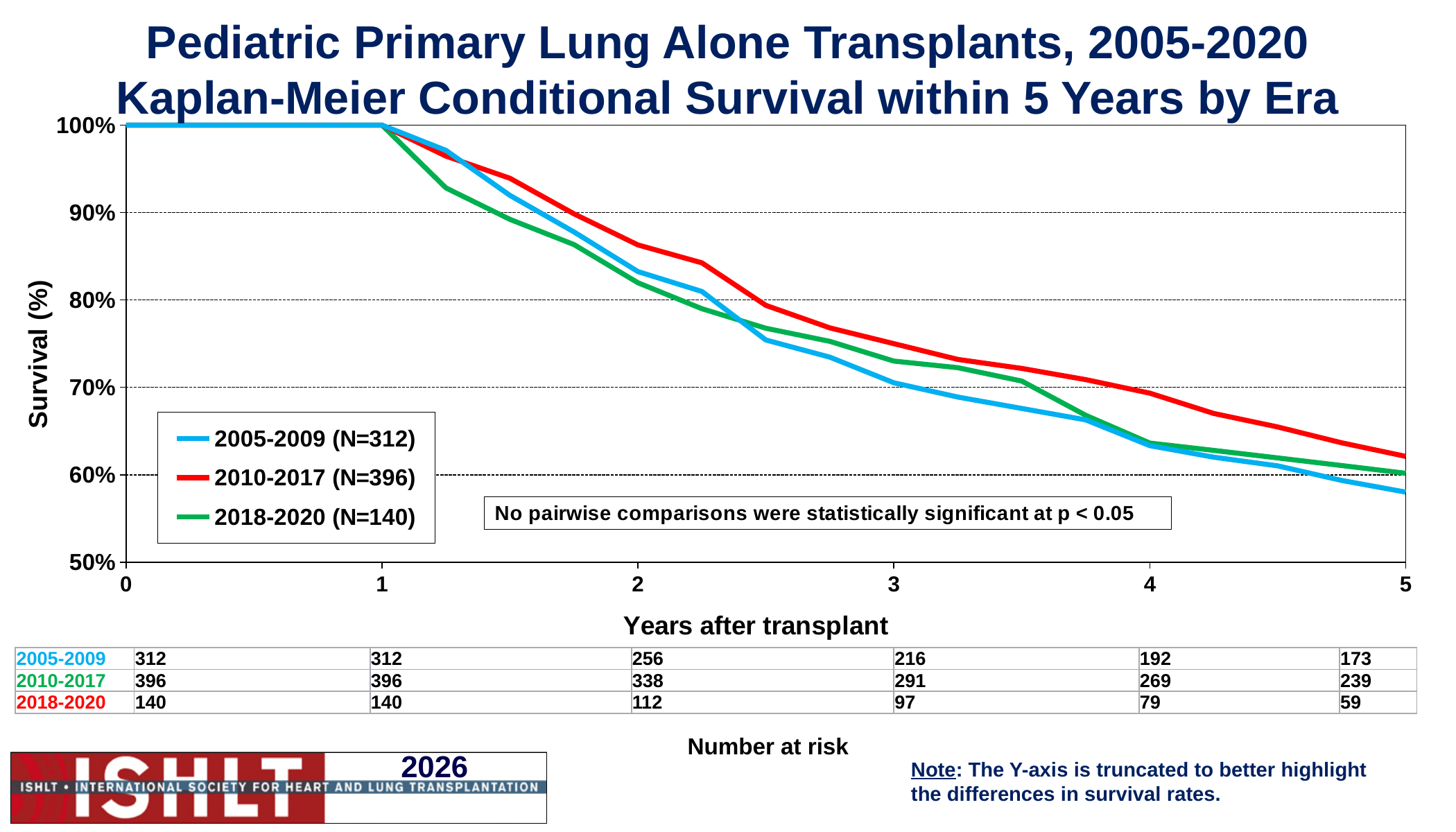
How many series does the legend list? 3 Is the survival for the 2010-2017 era at year 5 greater or less than 60%? greater What kind of chart is shown on the slide? line chart At year 5, which era has higher survival, 2005-2009 or 2010-2017? 2010-2017 In the number at risk table, by how much did the 2010-2017 number at risk decrease from year 0 to year 5? 157 Is the survival for the 2005-2009 era at year 5 greater or less than 60%? less Which era has the largest N in the legend? 2010-2017 (N=396) According to the number at risk table, how many 2010-2017 patients were at risk at year 2? 338 Do the survival curves rise or fall as years after transplant increase? fall What is the title of the chart? Pediatric Primary Lung Alone Transplants, 2005-2020 Kaplan-Meier Conditional Survival within 5 Years by Era According to the number at risk table, how many 2005-2009 patients were at risk at year 3? 216 According to the number at risk table, how many 2018-2020 patients were at risk at year 5? 59